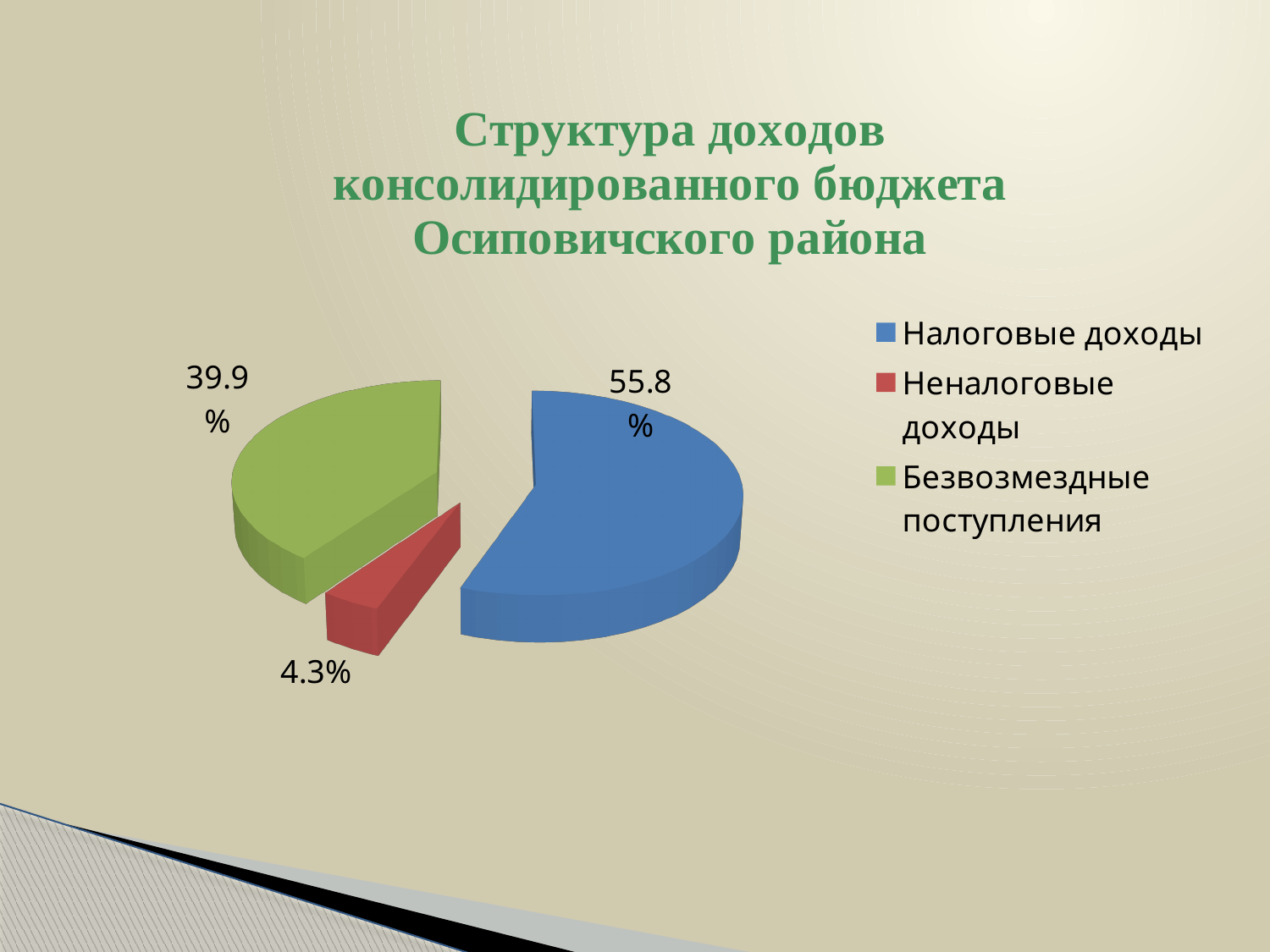
Which category has the largest share of the pie? Налоговые доходы What is the title of the chart? Структура доходов консолидированного бюджета Осиповичского района What colour is the slice for Безвозмездные поступления? green What share of the pie does Налоговые доходы have? 55.8% How many slices does the pie chart have? 3 Which category has the smallest share of the pie? Неналоговые доходы How many entries does the legend list? 3 What is the difference in percentage points between Налоговые доходы and Безвозмездные поступления? 15.9 What kind of chart is shown on the slide? pie chart Which is larger: the share for Безвозмездные поступления or the share for Неналоговые доходы? Безвозмездные поступления What share of the pie does Неналоговые доходы have? 4.3% What share of the pie does Безвозмездные поступления have? 39.9%